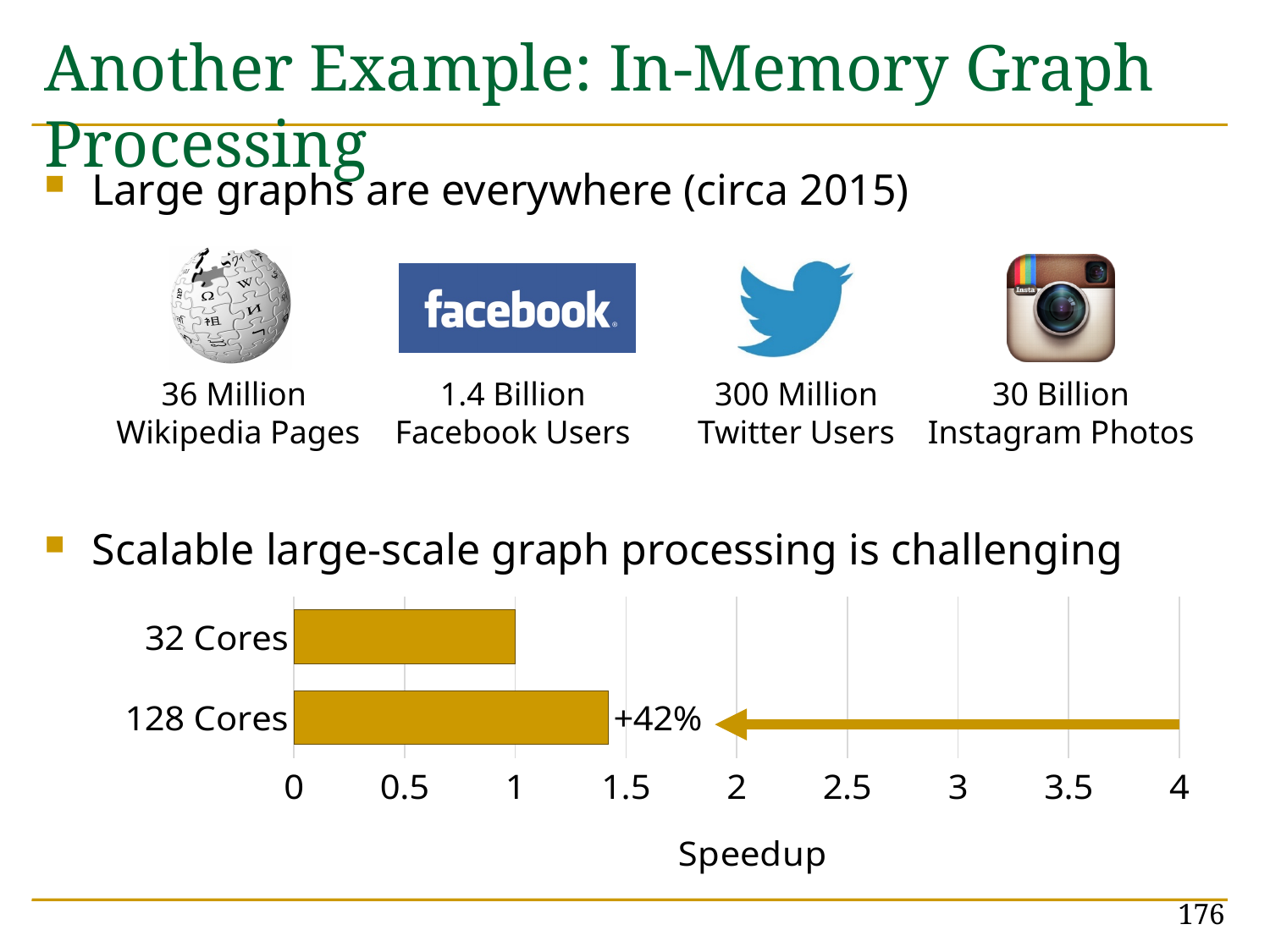
Which category has the lowest speedup? 32 Cores What is the label of the horizontal axis of the chart? Speedup Is the speedup for 128 Cores greater or less than 2? less What is the speedup value for 32 Cores? 1 Is the speedup for 128 Cores greater or less than 1? greater Which has a larger speedup, 32 Cores or 128 Cores? 128 Cores How many categories does the bar chart show? 2 Is the speedup for 128 Cores greater or less than 1.5? less What annotation is printed next to the 128 Cores bar? +42% What kind of chart is shown on the slide? bar chart What is the maximum value shown on the horizontal axis of the chart? 4 Which category has the highest speedup? 128 Cores